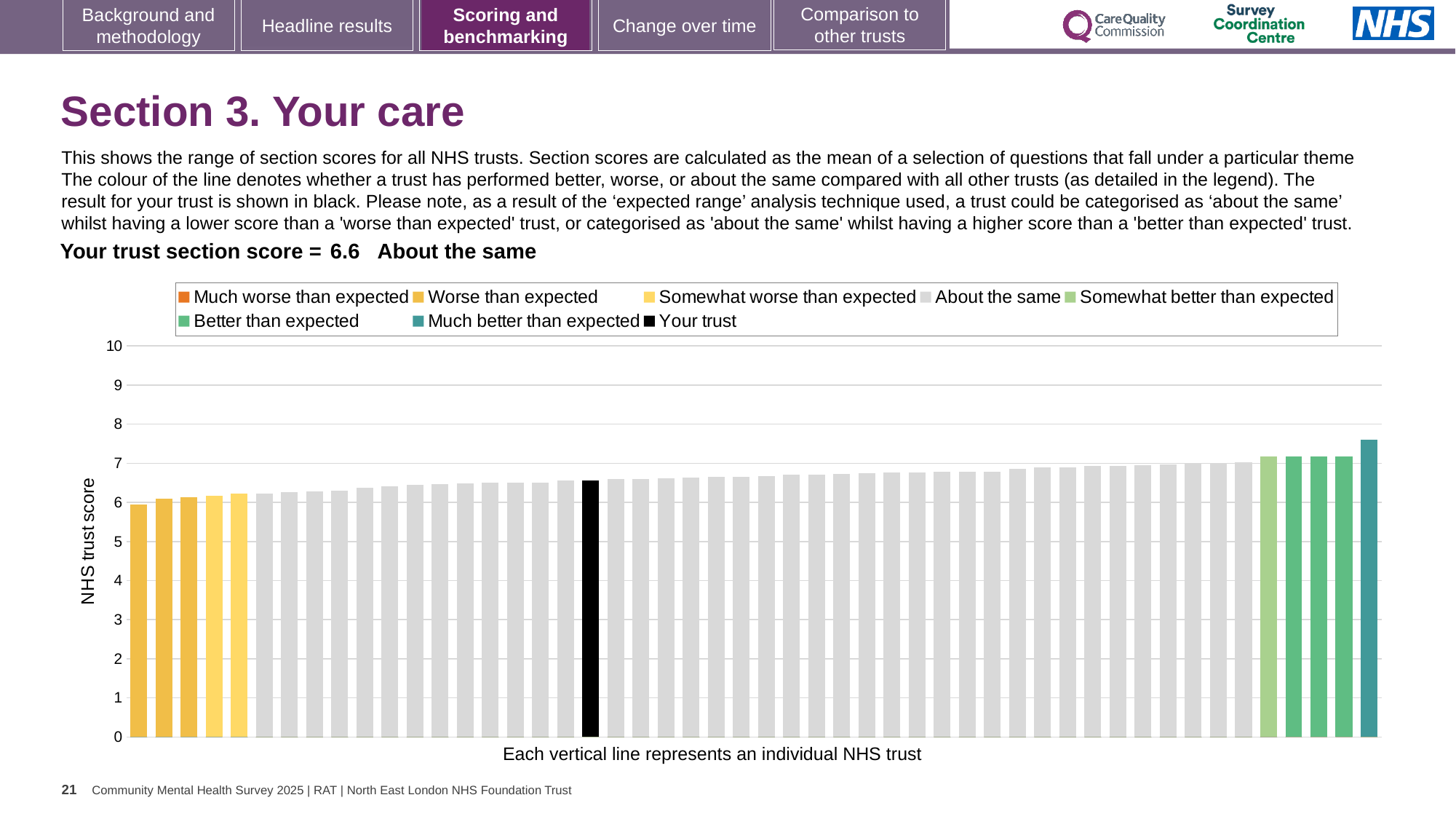
Is the value for your trust greater or less than 6? greater Which legend category does the highest bar on the chart belong to? Much better than expected What kind of chart is shown on the slide? bar chart What is the label on the vertical axis of the chart? NHS trust score Is the value for your trust greater or less than 7? less Is the highest bar on the chart greater or less than 8? less How many entries does the chart legend list? 8 What is the section score for your trust shown on the slide? 6.6 Do the bar values rise or fall from left to right along the x axis? rise Which performance category is your trust placed in for Section 3? About the same